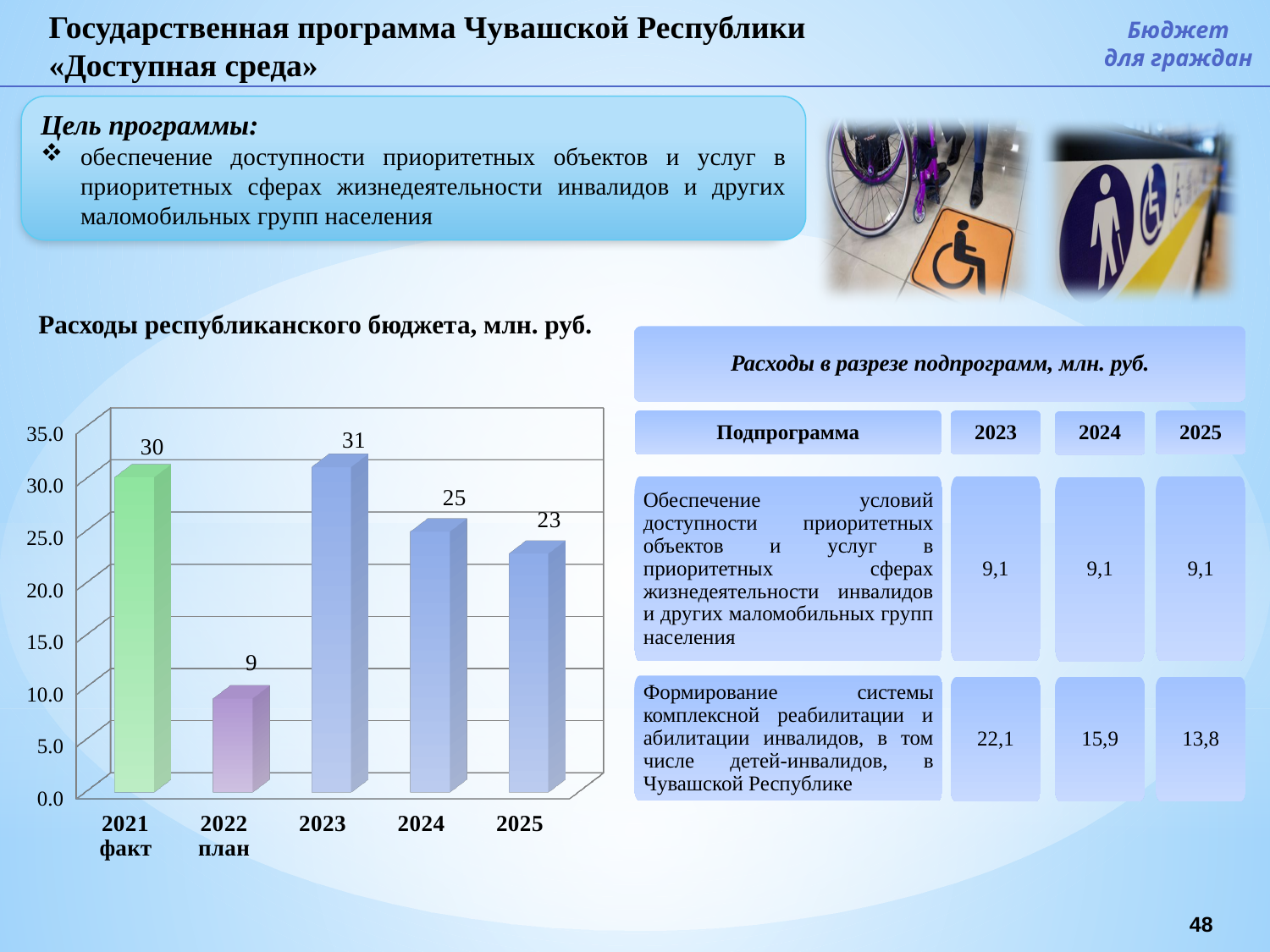
What is the difference between the values for 2023 and 2025 in the chart? 8 Which category has the lowest value in the chart? 2022 план Is the value for 2021 факт greater or less than 25.0? greater What is the difference between the values for 2021 факт and 2022 план? 21 Do the values rise or fall from 2023 to 2025 in the chart? Fall What kind of chart is shown on the slide? Bar chart Which category has the highest value in the chart? 2023 Which is larger in the chart: the value for 2024 or the value for 2025? 2024 How many categories are shown on the x axis of the chart? 5 What is the value for 2023 in the chart "Расходы республиканского бюджета, млн. руб."? 31 What is the value for 2022 план in the chart? 9 What is the value for 2025 in the chart? 23